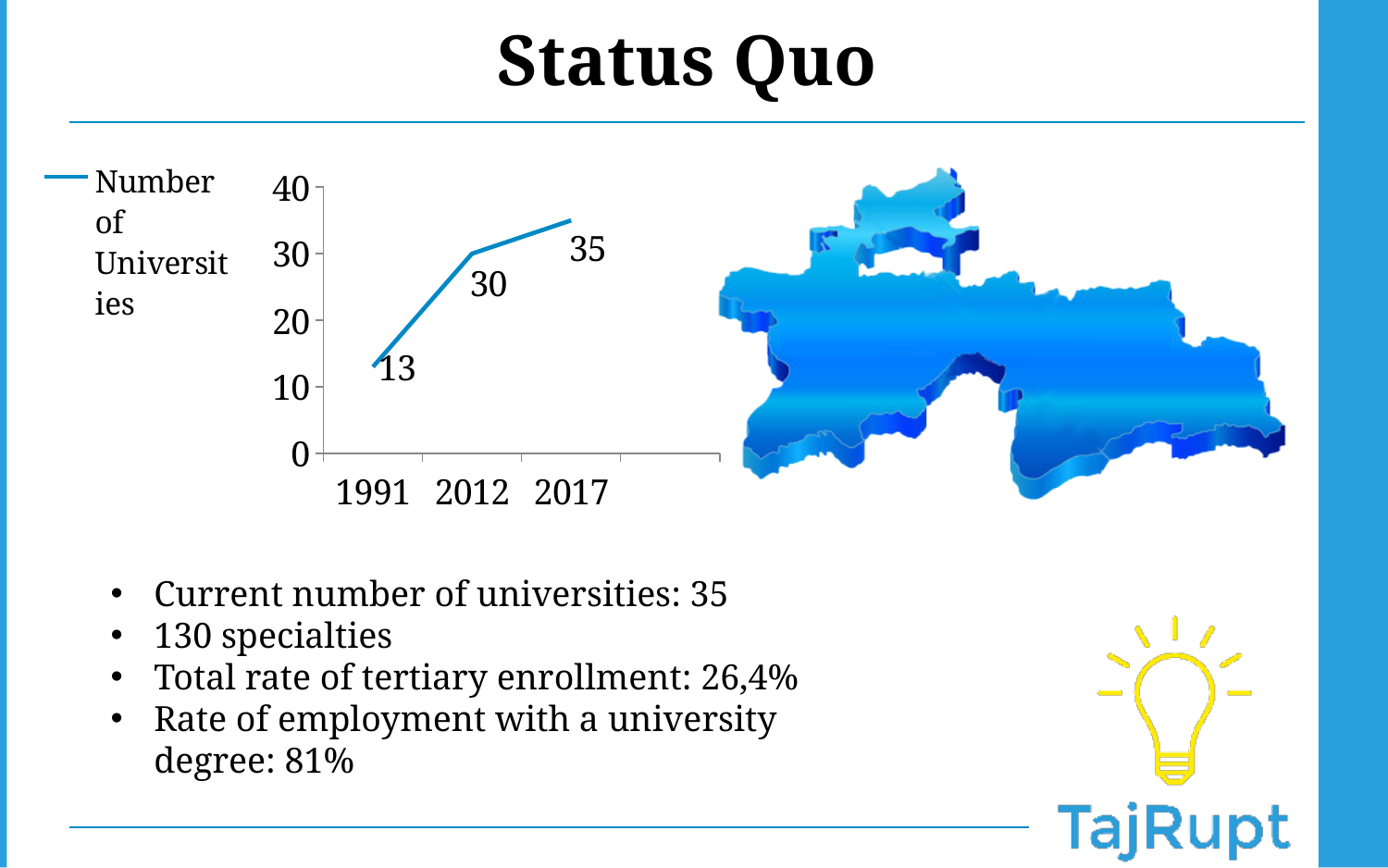
What series does the legend list? Number of Universities What is the number of universities in 2012? 30 What is the number of universities in 2017? 35 What is the number of universities in 1991? 13 What kind of chart is shown on the slide? line chart Does the number of universities rise or fall from 1991 to 2017? rise Which year has more universities, 1991 or 2012? 2012 What is the difference in the number of universities between 2017 and 1991? 22 Which year has the lowest number of universities? 1991 Which year has the highest number of universities? 2017 How many years are plotted on the chart? 3 What is the difference in the number of universities between 2012 and 1991? 17